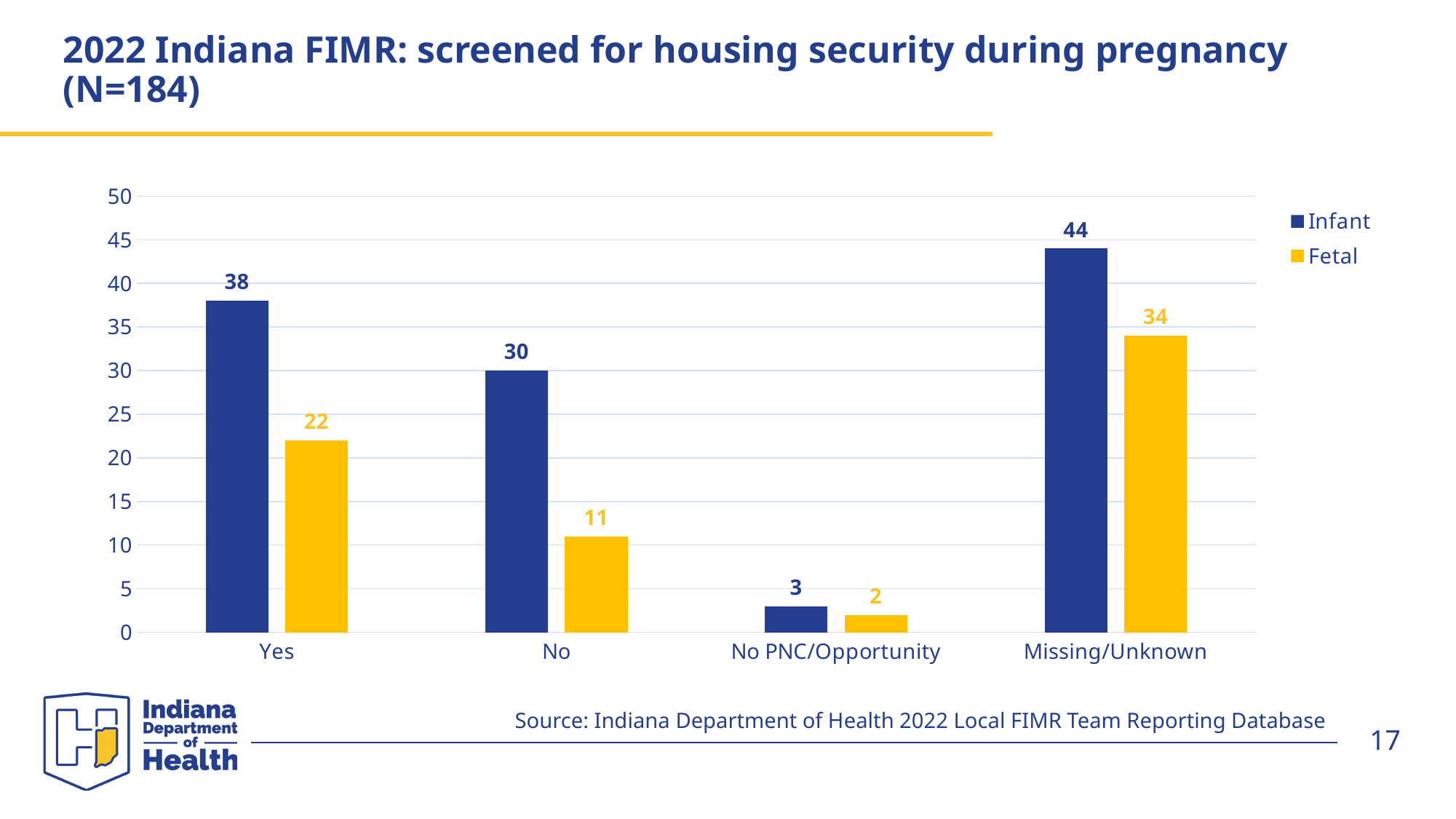
How many series does the legend list? 2 What kind of chart is shown on the slide? bar chart What is the difference between the Infant and Fetal values for the Yes category? 16 Which is larger, the Infant value for No or the Fetal value for Missing/Unknown? Fetal value for Missing/Unknown What colour represents the Fetal series? yellow What is the Infant value for the Yes category? 38 What is the Fetal value for the No category? 11 Which category has the highest Infant value? Missing/Unknown Which category has the lowest Fetal value? No PNC/Opportunity How many categories are shown on the x axis? 4 What is the Fetal value for Missing/Unknown? 34 Is the Infant value for Missing/Unknown greater or less than 40? greater